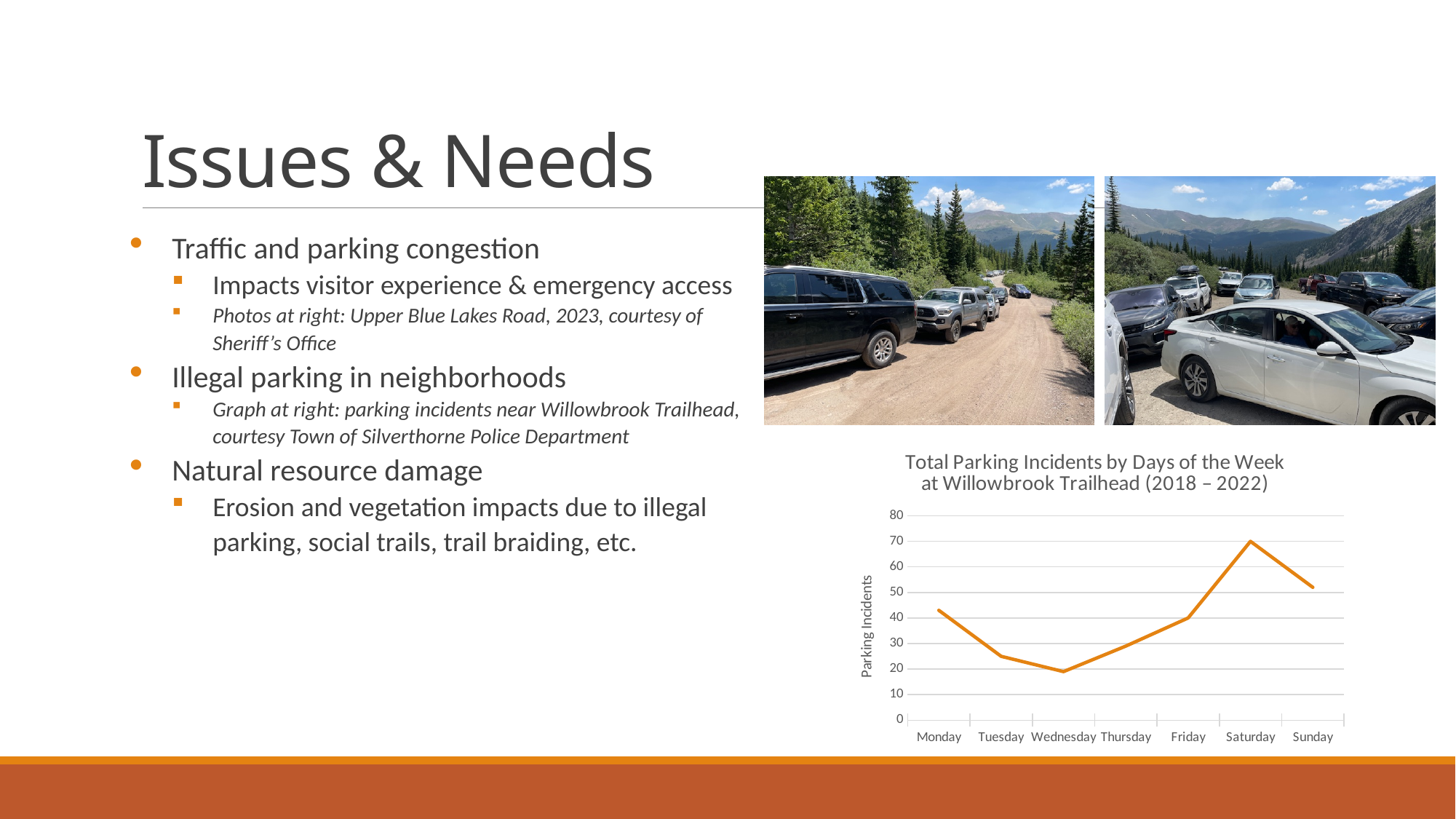
Which day of the week has the lowest number of parking incidents? Wednesday Which has more parking incidents, Monday or Tuesday? Monday Is the value for Wednesday greater or less than 30? less Is the value for Saturday greater or less than 60? greater Do parking incidents rise or fall from Wednesday to Saturday? rise Is the value for Tuesday greater or less than 40? less How many days of the week are plotted on the x axis? 7 What kind of chart is shown on the slide? line chart Which day of the week has the highest number of parking incidents? Saturday What is the title of the chart? Total Parking Incidents by Days of the Week at Willowbrook Trailhead (2018 – 2022) What is the label on the y axis of the chart? Parking Incidents